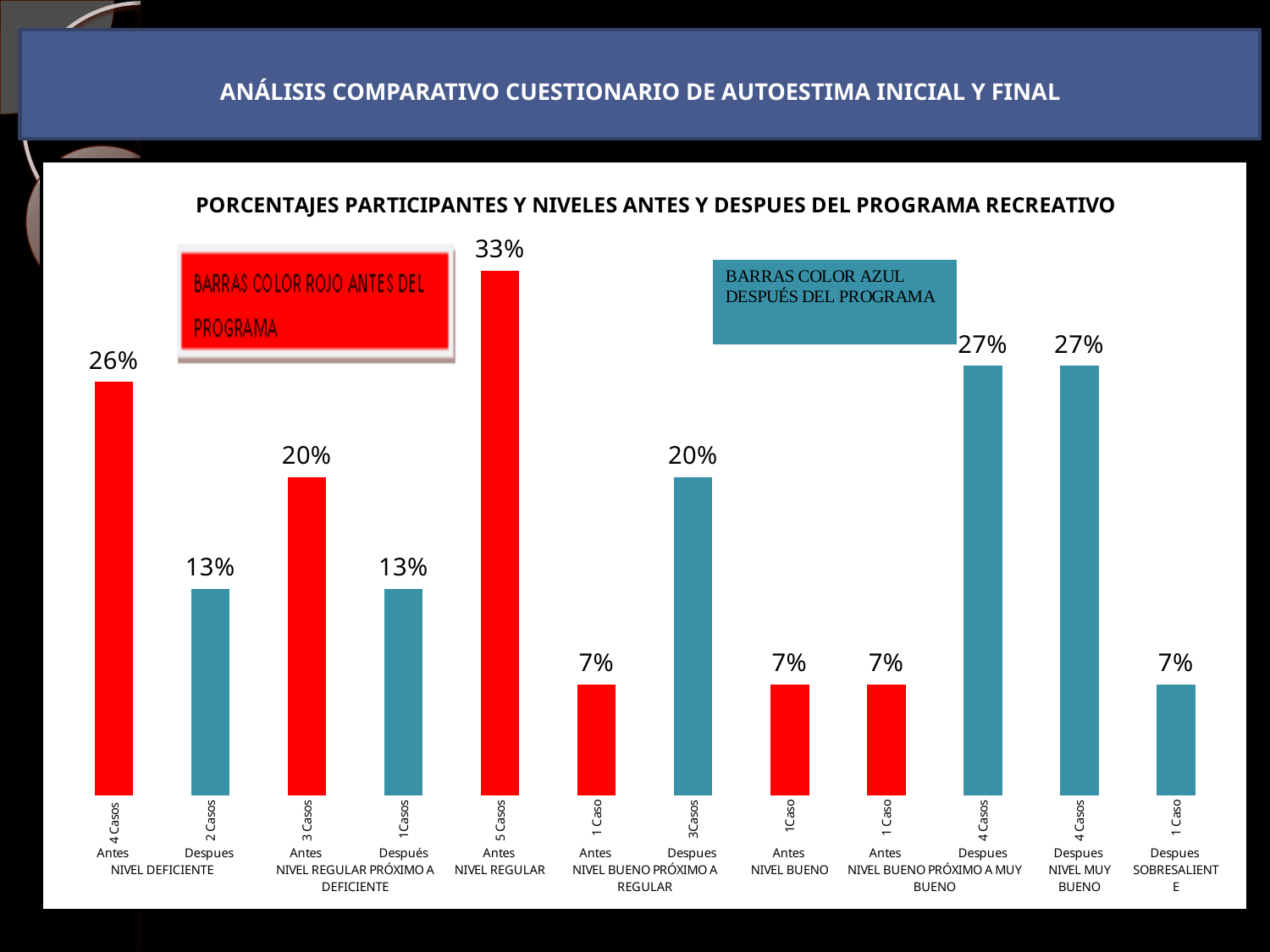
Which is larger: the Antes percentage for NIVEL REGULAR PRÓXIMO A DEFICIENTE or the Después percentage for the same level? Antes (20%) What is the difference between the Antes and Despues percentages for NIVEL DEFICIENTE? 13% What percentage is shown for Despues in NIVEL BUENO PRÓXIMO A MUY BUENO? 27% What type of chart is shown on the slide? Bar chart How many bars are plotted in the chart? 12 Which bar has the highest percentage in the chart? Antes, NIVEL REGULAR (33%) What percentage is shown for Antes in NIVEL REGULAR? 33% What percentage is shown for Despues in NIVEL DEFICIENTE? 13% What percentage is shown for Antes in NIVEL DEFICIENTE? 26% What percentage is shown for Despues in SOBRESALIENTE? 7% What is the difference between the Despues percentage for NIVEL BUENO PRÓXIMO A REGULAR and the Antes percentage for the same level? 13% According to the text boxes on the chart, what do the red bars represent? Antes del programa (before the program)